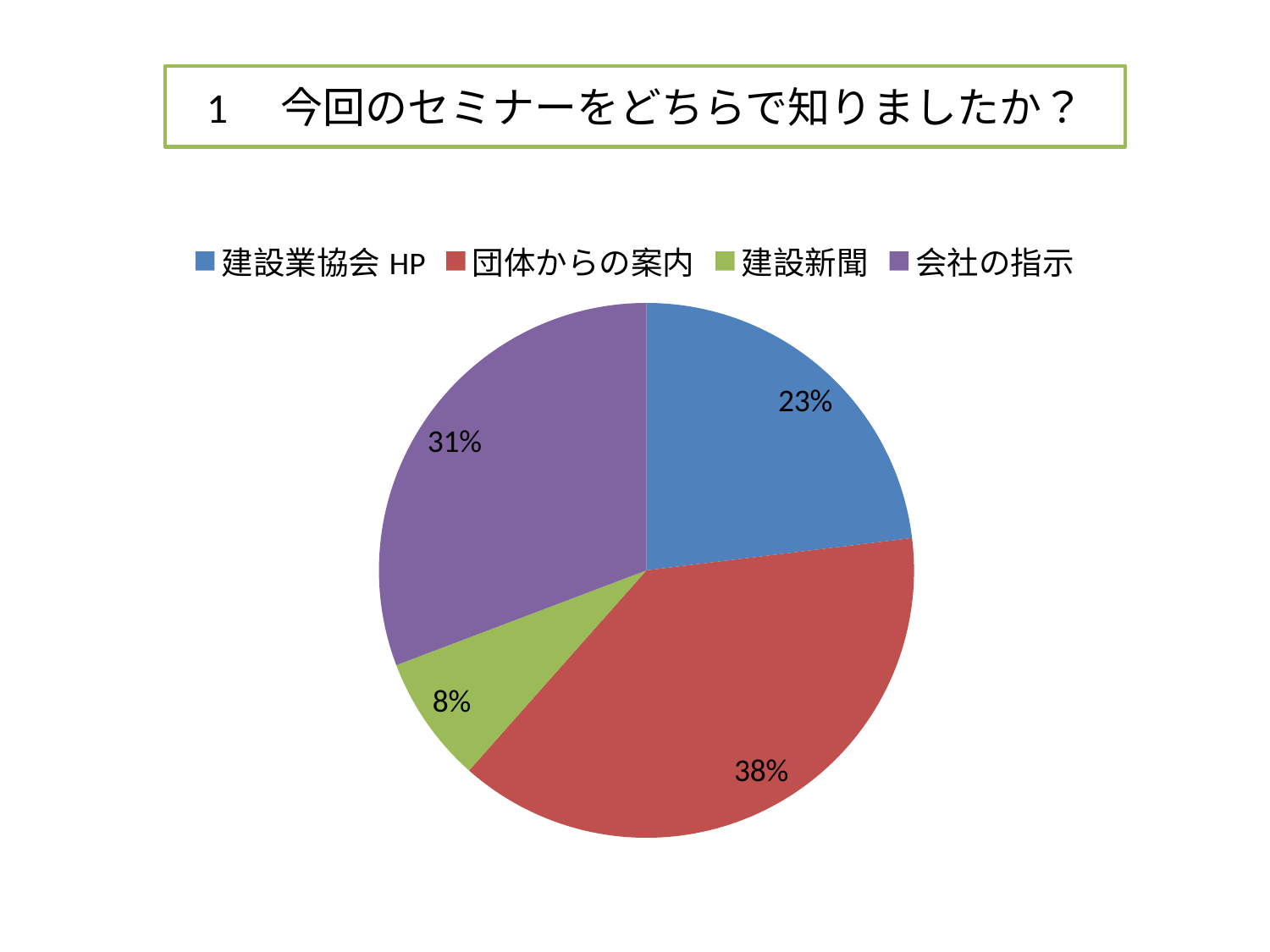
What kind of chart is shown on the slide? pie chart What is the difference in percentage points between 団体からの案内 and 建設業協会 HP? 15 What share of the pie does 団体からの案内 have? 38% What share of the pie does 会社の指示 have? 31% Which category has the smallest slice of the pie? 建設新聞 How many categories are shown in the pie chart? 4 What share of the pie does 建設新聞 have? 8% What is the difference in percentage points between 会社の指示 and 建設新聞? 23 Which is larger, the slice for 会社の指示 or the slice for 建設業協会 HP? 会社の指示 What colour is the slice for 建設新聞? green Which category has the largest slice of the pie? 団体からの案内